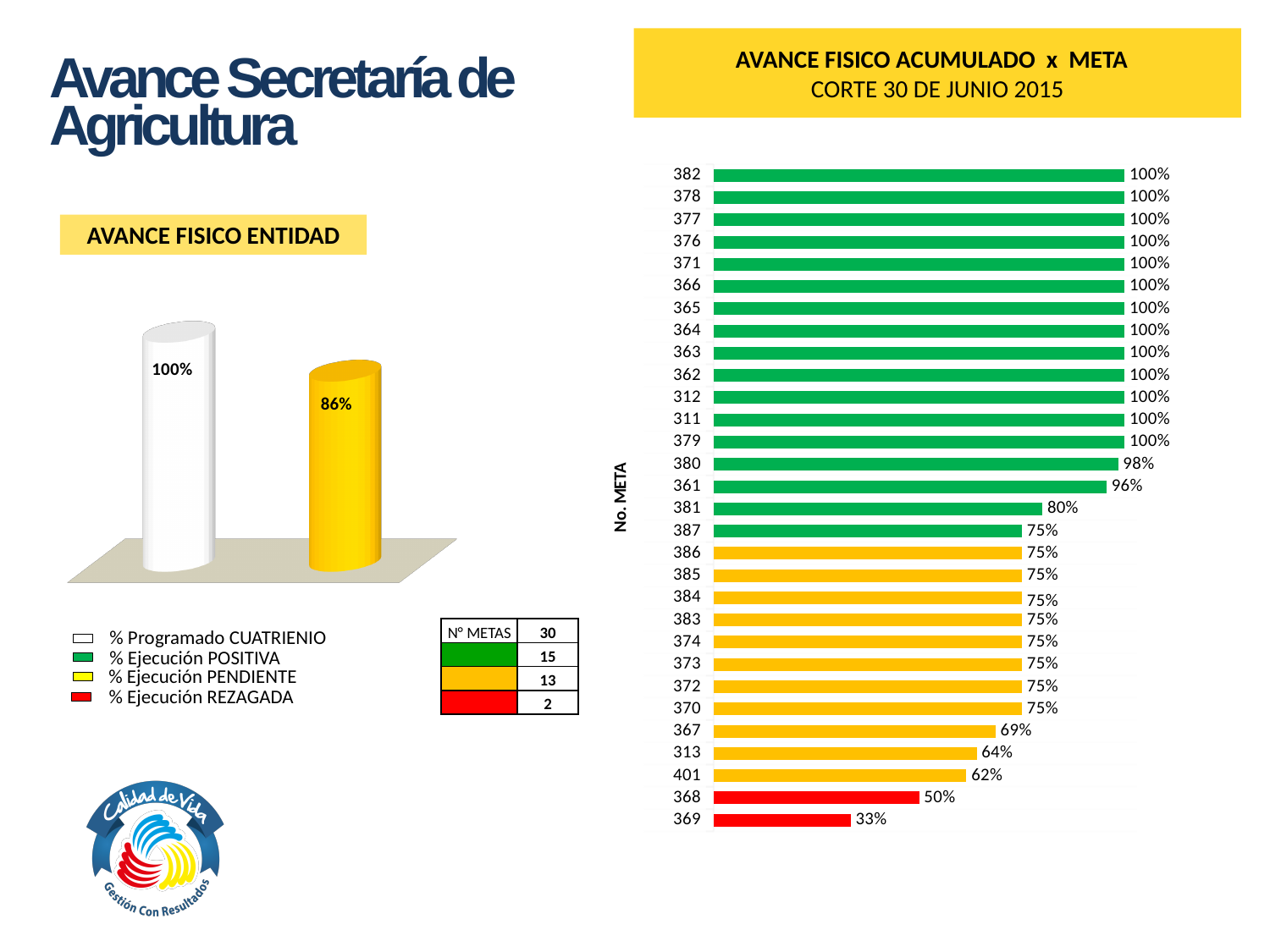
In the AVANCE FISICO ENTIDAD chart, what is the value of the yellow bar? 86% In the AVANCE FISICO ACUMULADO x META chart, which meta has the lowest value? 369 How many metas are shown in the AVANCE FISICO ACUMULADO x META chart? 30 What kind of chart is the AVANCE FISICO ACUMULADO x META chart? Bar chart In the AVANCE FISICO ACUMULADO x META chart, what is the value for meta 367? 69% In the AVANCE FISICO ACUMULADO x META chart, what is the value for meta 361? 96% In the AVANCE FISICO ACUMULADO x META chart, what is the value for meta 369? 33% In the AVANCE FISICO ACUMULADO x META chart, which is larger, the value for meta 313 or the value for meta 401? 313 In the AVANCE FISICO ACUMULADO x META chart, what is the value for meta 380? 98% In the AVANCE FISICO ENTIDAD chart, what is the difference between the two bars? 14% What is the cut-off date shown in the title of the AVANCE FISICO ACUMULADO x META chart? 30 de junio 2015 In the AVANCE FISICO ACUMULADO x META chart, what is the difference between the values for meta 368 and meta 369? 17%